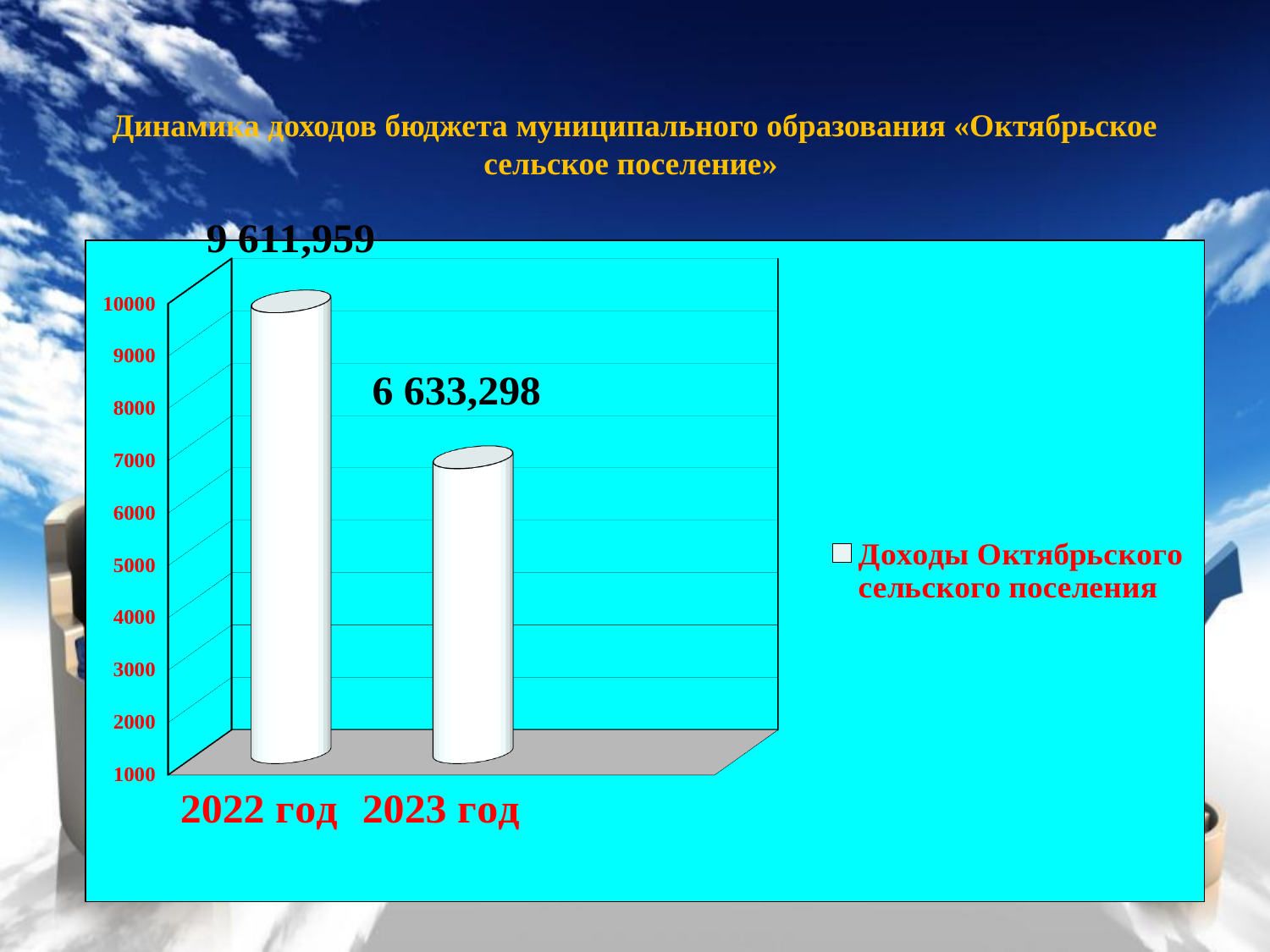
What is the difference between the values for 2022 год and 2023 год? 2 978,661 Do the values rise or fall from 2022 год to 2023 год? fall Is the value for 2022 год greater or less than 9000? greater Is the value for 2023 год greater or less than 7000? less What is the value for 2022 год? 9 611,959 Which year has the highest value? 2022 год What kind of chart is shown on the slide? bar chart How many categories are shown on the x axis? 2 How many series does the legend list? 1 What is the value for 2023 год? 6 633,298 Which is larger, the value for 2022 год or the value for 2023 год? 2022 год Which year has the lowest value? 2023 год